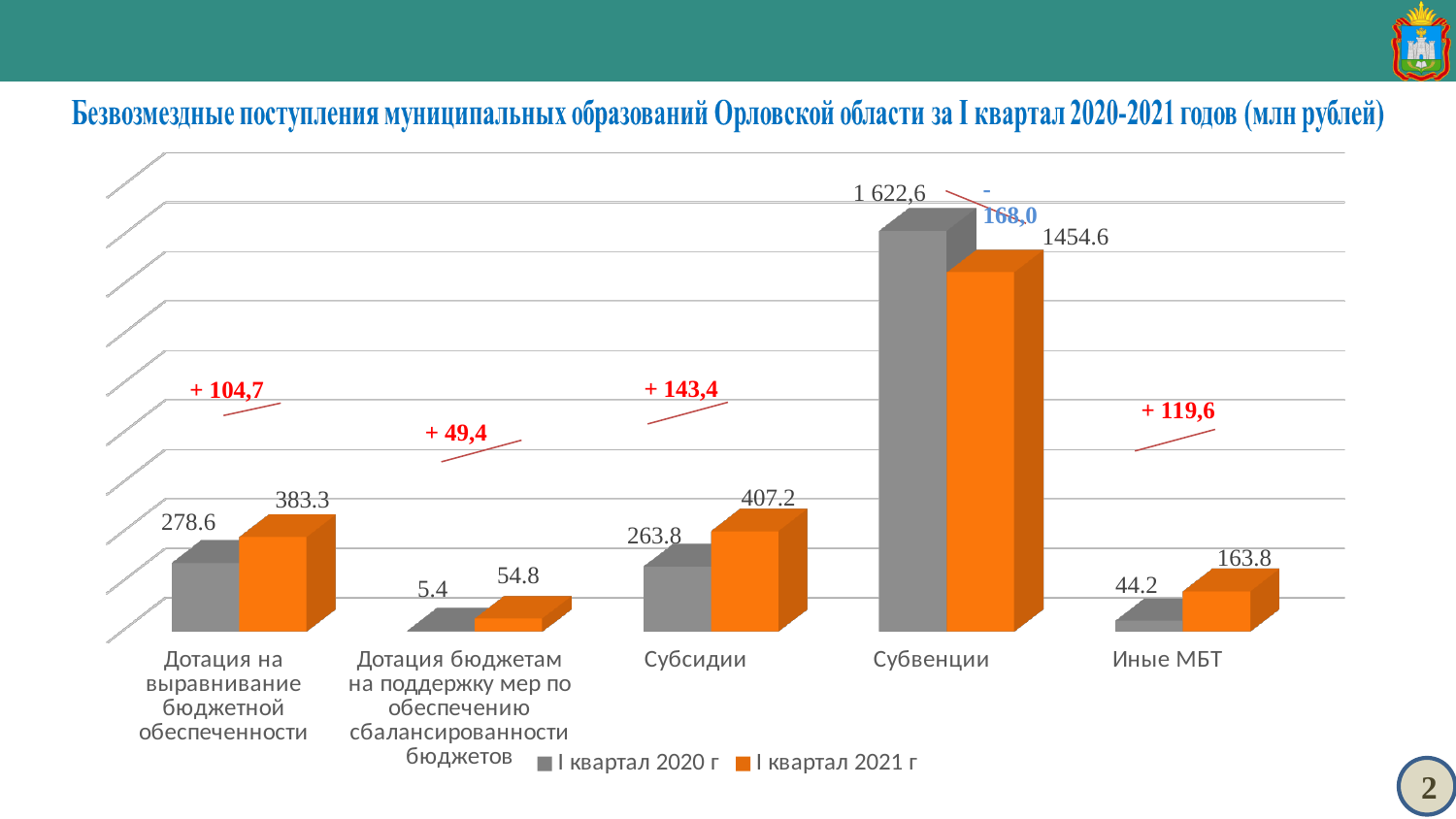
What is the difference between the I квартал 2021 г and I квартал 2020 г values for Дотация на выравнивание бюджетной обеспеченности? 104.7 What is the value for Дотация бюджетам на поддержку мер по обеспечению сбалансированности бюджетов in I квартал 2021 г? 54.8 What type of chart is shown on the slide? bar chart What is the value for Иные МБТ in I квартал 2020 г? 44.2 What colour are the bars for I квартал 2021 г? orange What is the value for Субвенции in I квартал 2020 г? 1 622,6 What is the value for Субсидии in I квартал 2021 г? 407.2 For Субвенции, which is larger: the I квартал 2020 г value or the I квартал 2021 г value? I квартал 2020 г How many series does the legend list? 2 Which category has the lowest value in I квартал 2020 г? Дотация бюджетам на поддержку мер по обеспечению сбалансированности бюджетов Which category has the highest value in I квартал 2021 г? Субвенции How many categories are shown on the x axis? 5